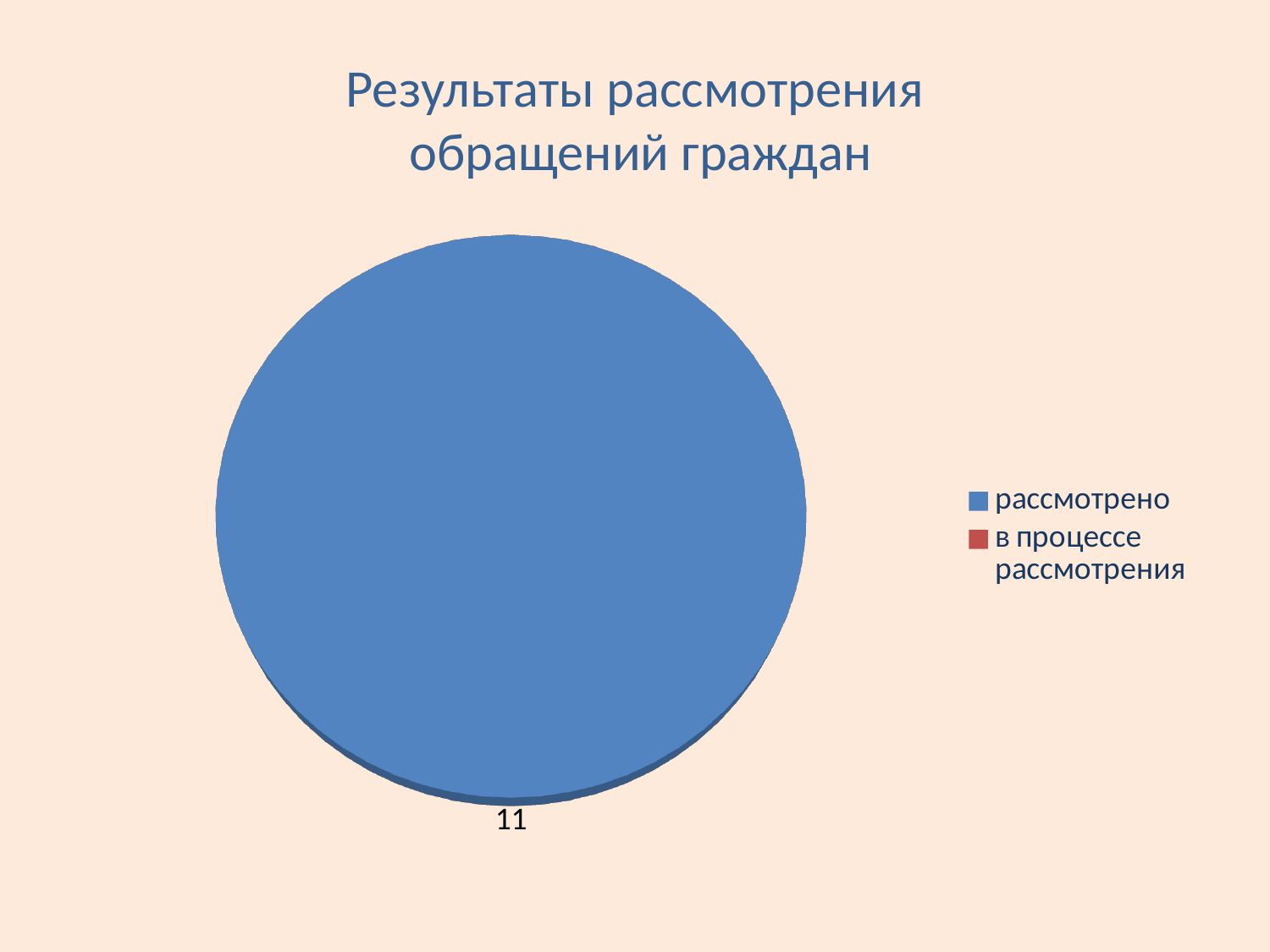
How many entries does the legend list? 2 Which legend entry does the visible slice of the pie belong to? рассмотрено What is the title of the chart? Результаты рассмотрения обращений граждан Which category has the largest share of the pie? рассмотрено Which is larger, "рассмотрено" or "в процессе рассмотрения"? рассмотрено What colour represents "рассмотрено" in the legend? blue What kind of chart is shown on the slide? pie chart What value is printed on the pie chart for "рассмотрено"? 11 How many slices are visible in the pie chart? 1